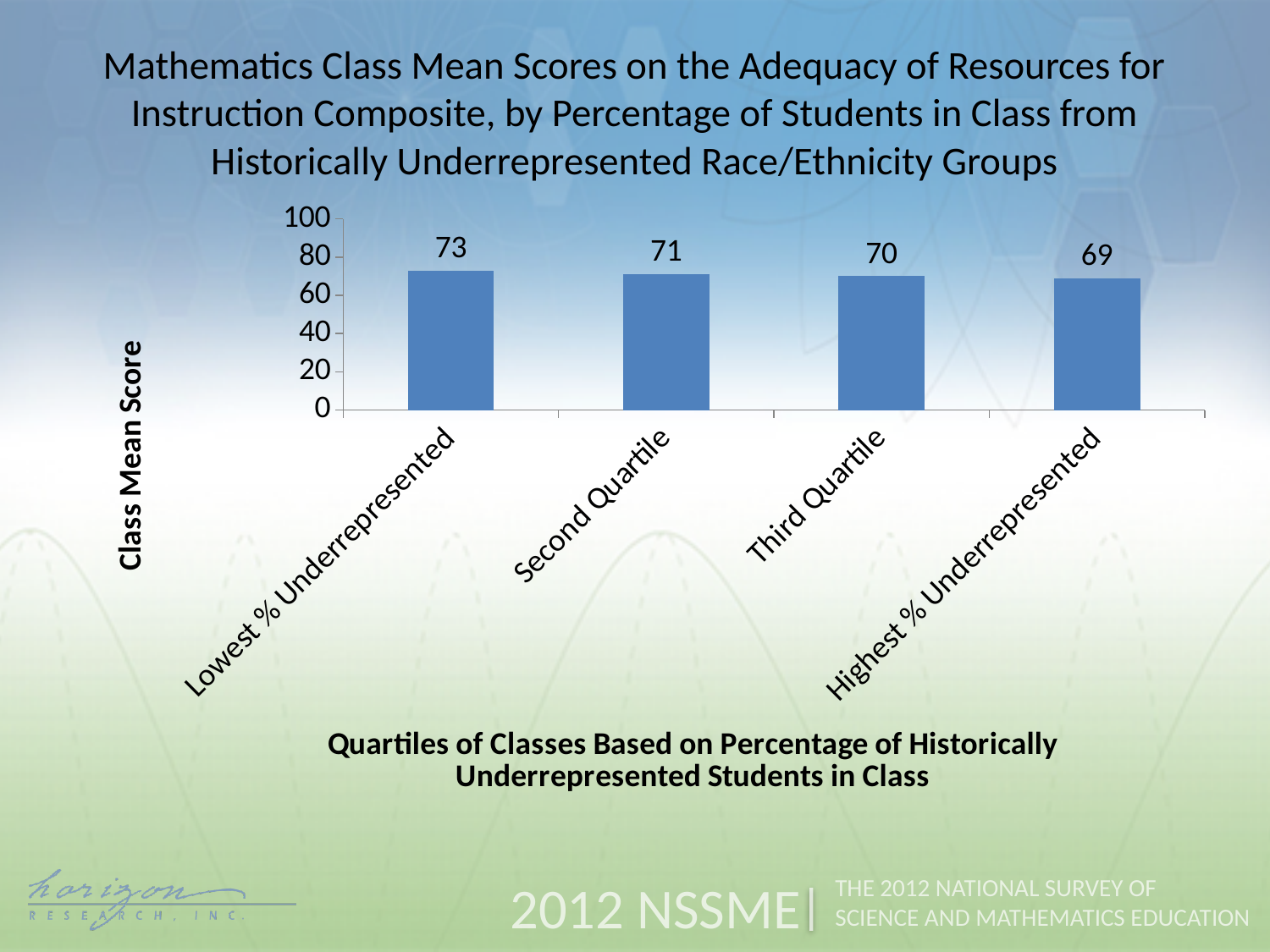
What is the class mean score for the Highest % Underrepresented quartile? 69 How many quartile categories are shown in the chart? 4 Which quartile has the highest class mean score? Lowest % Underrepresented What is the difference between the class mean scores for the Lowest % Underrepresented and Highest % Underrepresented quartiles? 4 Do the class mean scores rise or fall from the Lowest % Underrepresented quartile to the Highest % Underrepresented quartile? Fall Which has a higher class mean score, the Second Quartile or the Third Quartile? Second Quartile What is the class mean score for the Second Quartile? 71 Is the class mean score for the Third Quartile greater or less than 80? less What kind of chart is shown on the slide? Bar chart What is the class mean score for the Third Quartile? 70 Which quartile has the lowest class mean score? Highest % Underrepresented What is the class mean score for the Lowest % Underrepresented quartile? 73